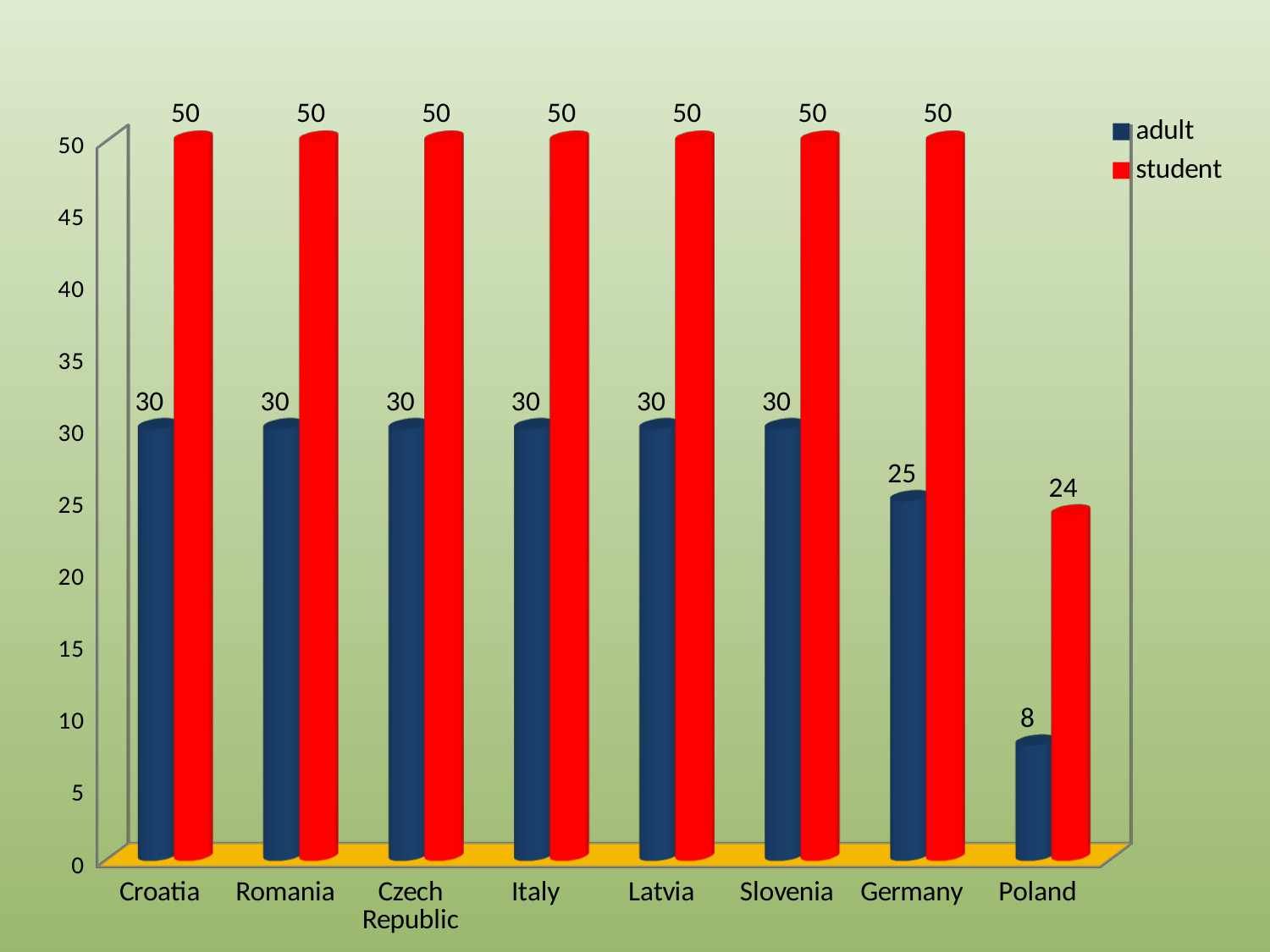
How many countries are shown on the x axis? 8 What colour are the student bars? red What is the student value for Poland? 24 Which country has the lowest student value? Poland What is the adult value for Croatia? 30 How many series does the legend list? 2 What is the difference between the student and adult values for Germany? 25 What is the difference between the student and adult values for Poland? 16 Which is larger for Italy, the adult value or the student value? student What kind of chart is shown on the slide? bar chart What is the adult value for Germany? 25 Which country has the lowest adult value? Poland